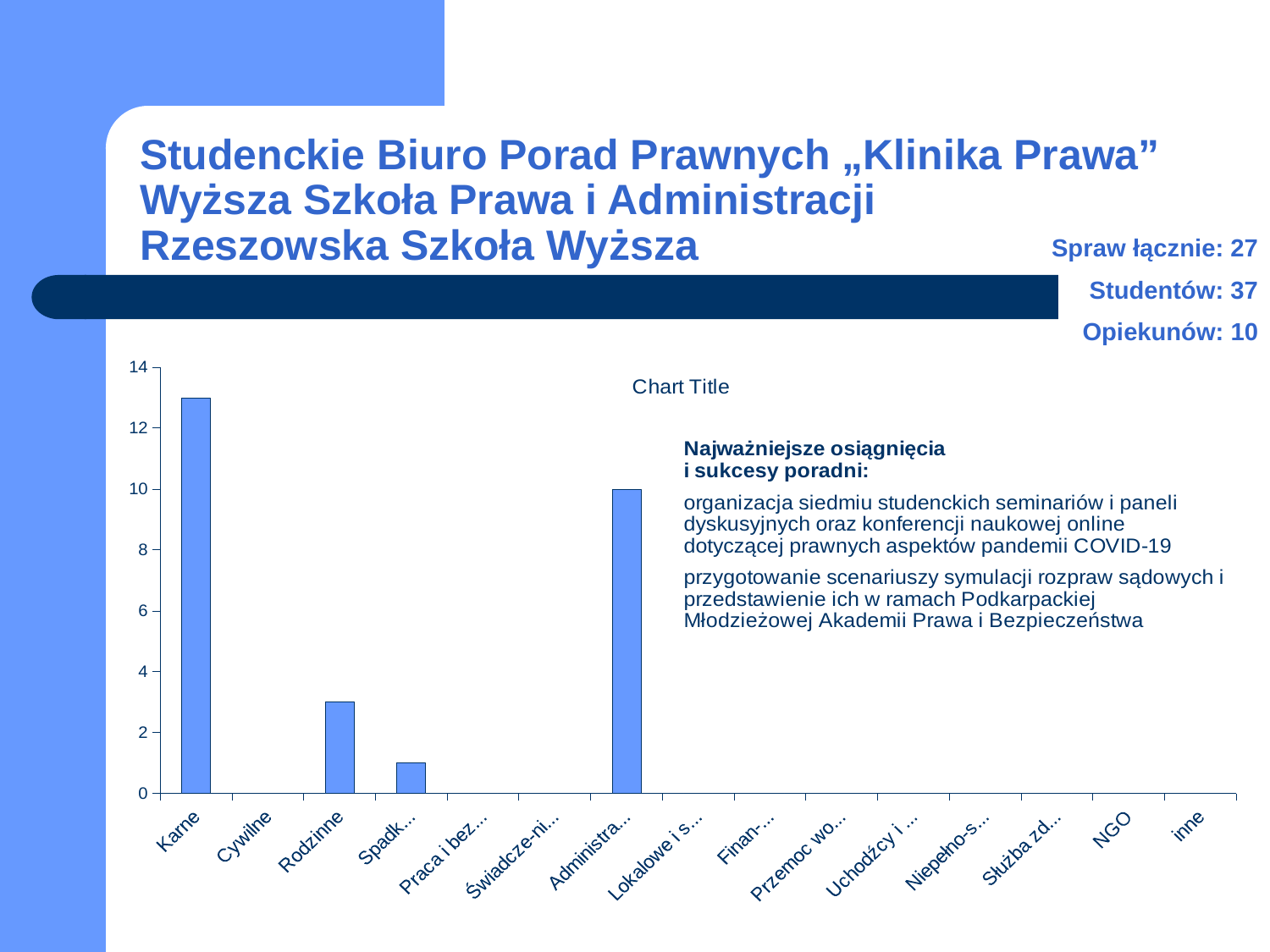
What is the title shown on the chart? Chart Title What is the value for Administra... in the chart? 10 What kind of chart is shown on the slide? bar chart Is the value for Spadk... greater or less than 2? less Which is larger, the value for Karne or the value for Administra...? Karne Which category has the highest bar in the chart? Karne How many categories are shown on the x axis of the chart? 15 How many categories in the chart have a visible bar above zero? 4 Is the value for Karne greater or less than 14? less Which is larger, the value for Rodzinne or the value for Spadk...? Rodzinne Is the value for Rodzinne greater or less than 2? greater